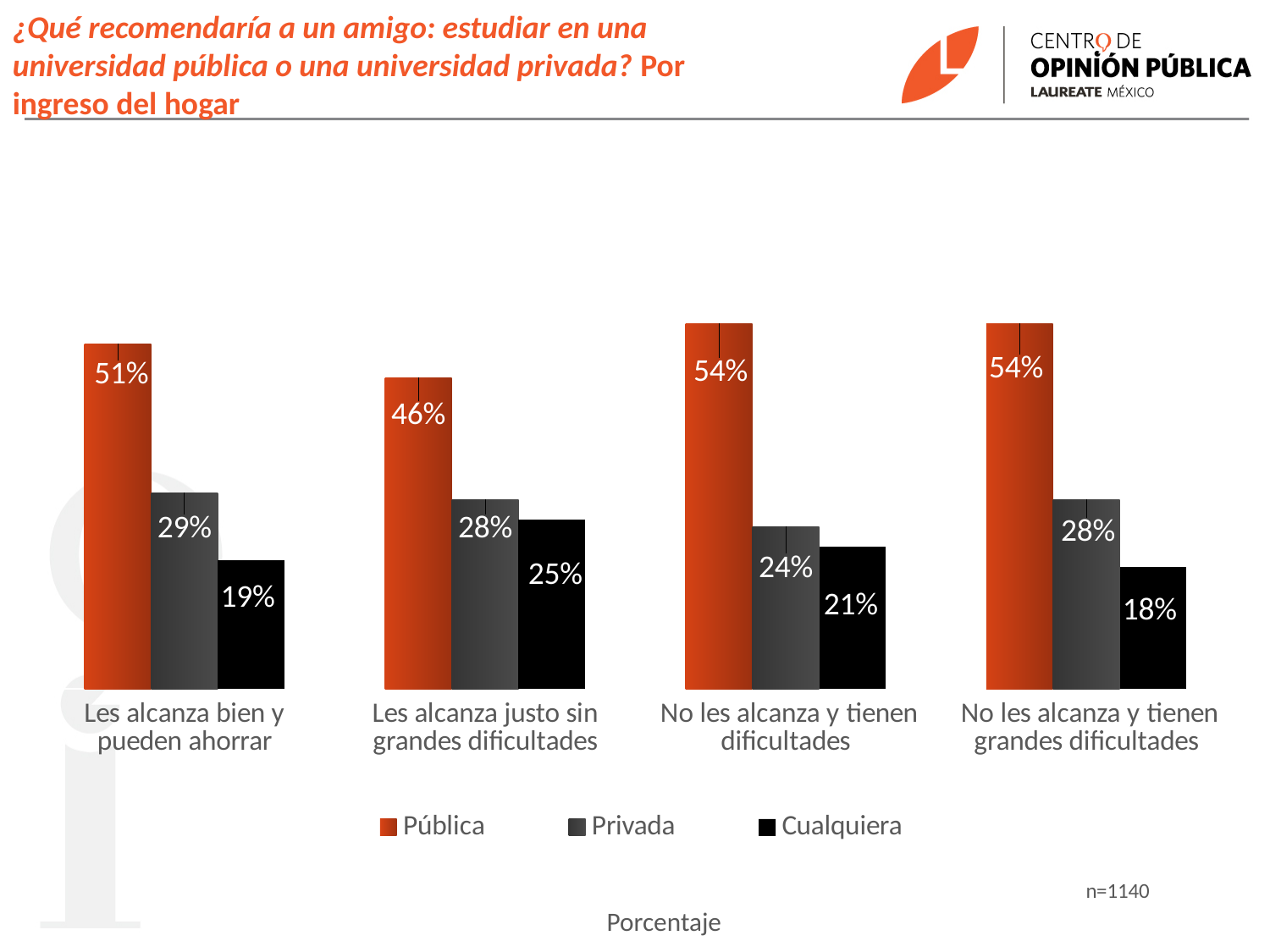
Which legend entry is shown in orange? Pública What kind of chart is shown on the slide? Bar chart Which income group has the highest value for Cualquiera? Les alcanza justo sin grandes dificultades Which income group has the lowest value for Pública? Les alcanza justo sin grandes dificultades What is the value for Privada in the 'No les alcanza y tienen dificultades' group? 24% What is the sample size (n) shown on the slide? n=1140 How many series does the legend list? 3 What percentage recommends a public university (Pública) among those whose income 'Les alcanza bien y pueden ahorrar'? 51% What is the difference between Pública and Privada in the 'Les alcanza bien y pueden ahorrar' group? 22% What is the value for Cualquiera in the 'No les alcanza y tienen grandes dificultades' group? 18% In the 'Les alcanza justo sin grandes dificultades' group, which is larger: Privada or Cualquiera? Privada How many income groups are shown on the x axis? 4